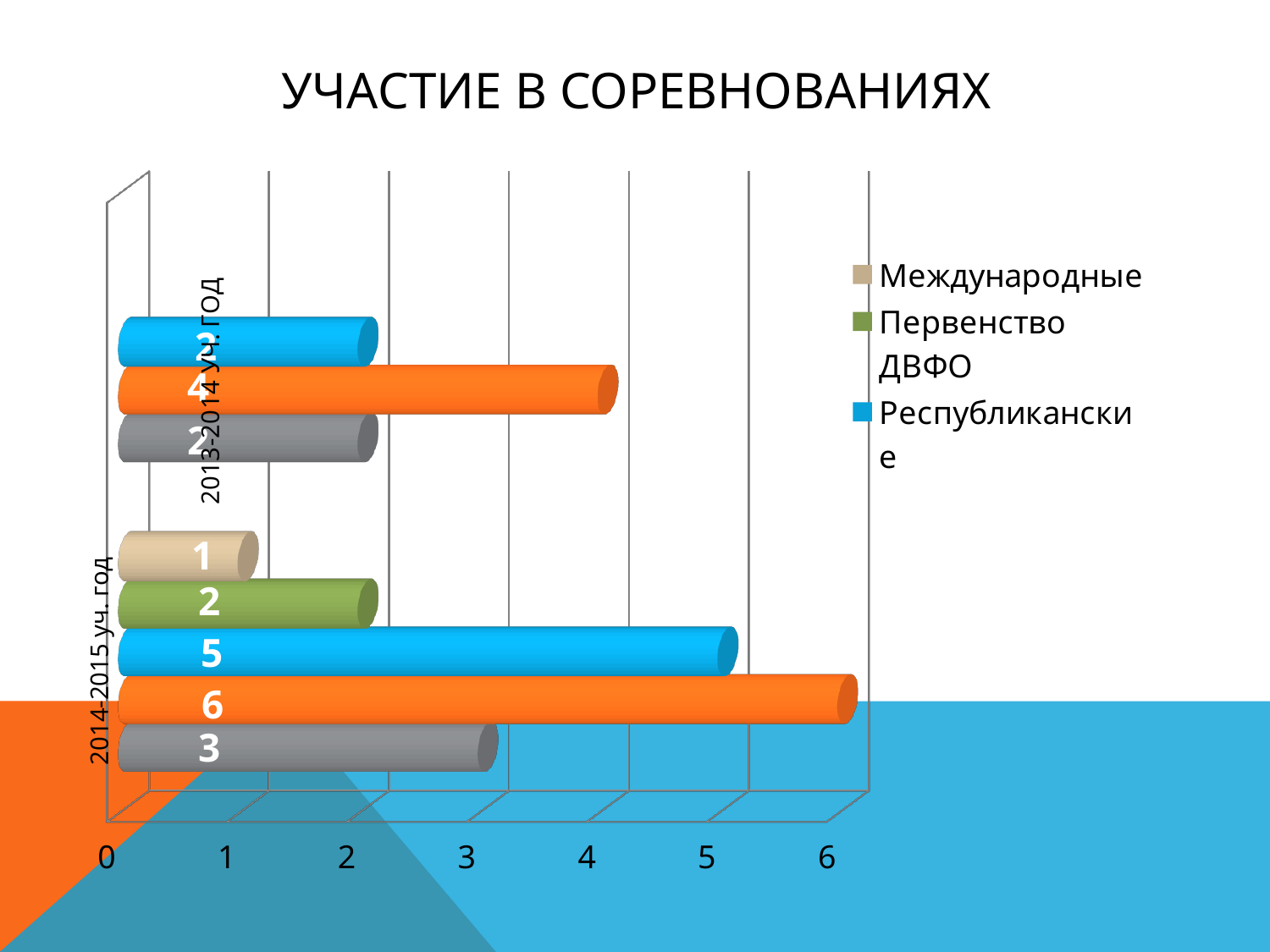
In 2014-2015 уч. год, which is larger: Республиканские or Первенство ДВФО? Республиканские By how much did the value for Республиканские increase from 2013-2014 уч. год to 2014-2015 уч. год? 3 What is the value for Международные in 2014-2015 уч. год? 1 What kind of chart is shown on the slide? bar chart What is the value for Первенство ДВФО in 2014-2015 уч. год? 2 How many series does the legend list? 3 Is the value for Республиканские in 2014-2015 уч. год greater or less than 4? greater What is the value for Республиканские in 2014-2015 уч. год? 5 What is the title of the chart? УЧАСТИЕ В СОРЕВНОВАНИЯХ What is the value for Республиканские in 2013-2014 уч. год? 2 Among the series named in the legend, which has the lowest value in 2014-2015 уч. год? Международные How many academic-year categories are shown on the chart? 2